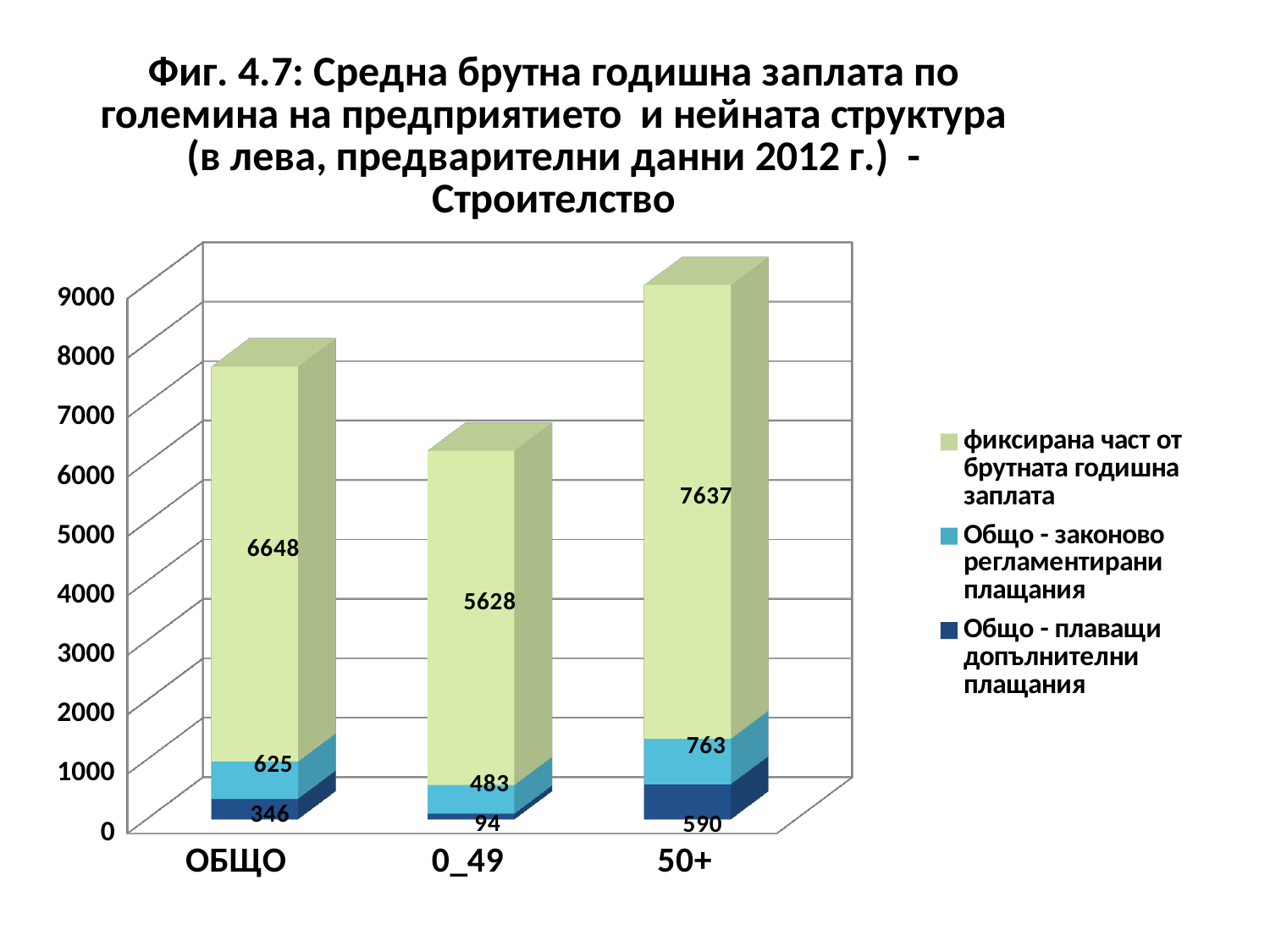
What is the total of the stacked bar for the ОБЩО category? 7619 What is the value of Общо - плаващи допълнителни плащания for the 0_49 category? 94 What is the value of the fixed part of the gross annual salary (фиксирана част от брутната годишна заплата) for the 50+ category? 7637 What is the total of the stacked bar for the 0_49 category? 6205 Which category has the highest value for the fixed part of the gross annual salary? 50+ How many categories are shown on the x axis? 3 What is the difference between the fixed part of the gross annual salary for 50+ and for 0_49? 2009 Which category has the lowest value for Общо - плаващи допълнителни плащания? 0_49 How many series does the legend list? 3 Which is larger: Общо - законово регламентирани плащания for ОБЩО or for 50+? 50+ What kind of chart is shown on the slide? Stacked bar chart What is the value of Общо - законово регламентирани плащания for the ОБЩО category? 625